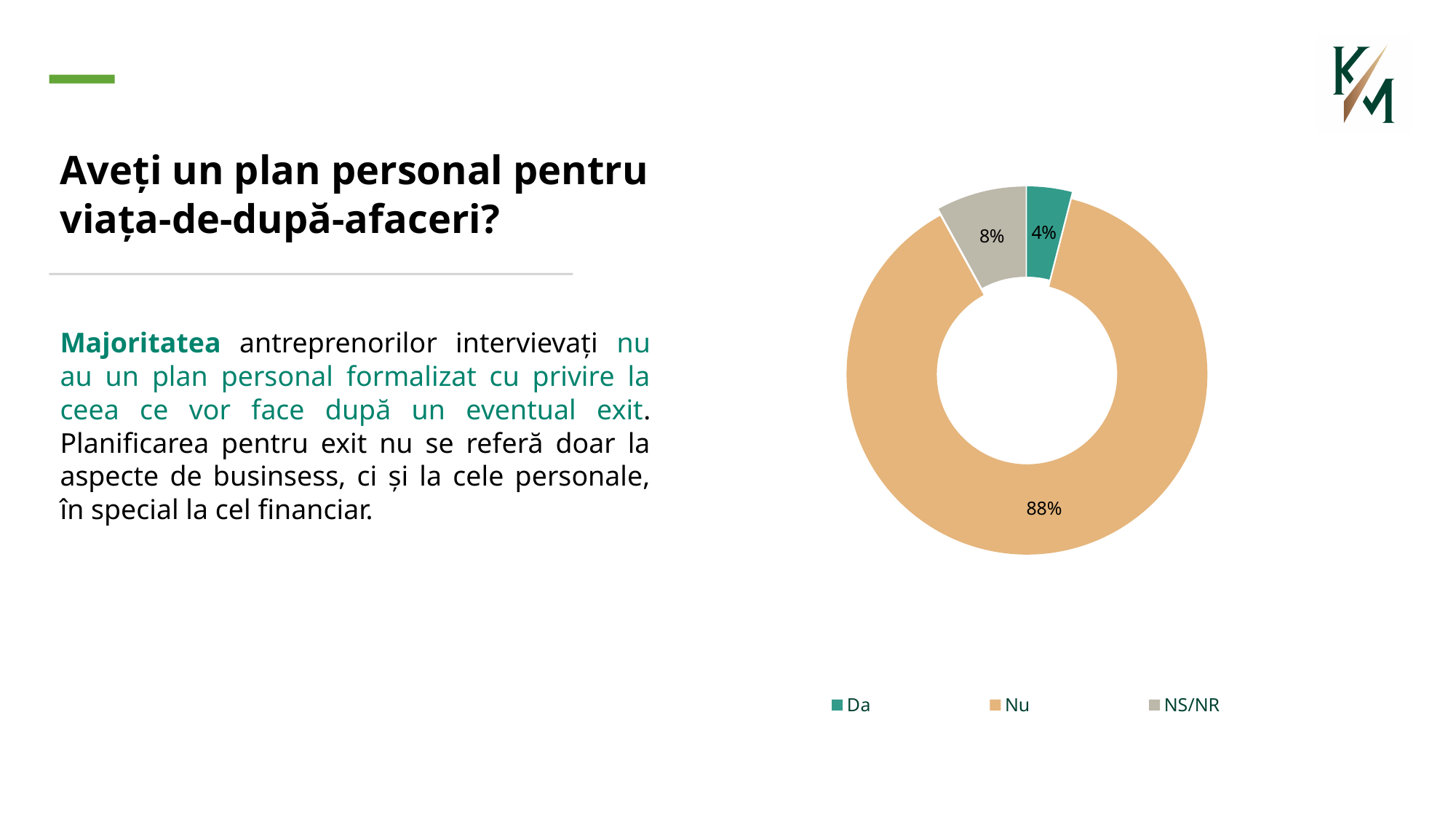
Which category has the largest share of the chart? Nu Which category has the smallest share of the chart? Da What kind of chart is shown on the slide? Doughnut (pie) chart How many entries does the legend list? 3 What is the difference in percentage points between "Nu" and "Da"? 84 What percentage of respondents answered "Da"? 4% What is the difference in percentage points between "NS/NR" and "Da"? 4 How many categories does the chart show? 3 What percentage of respondents answered "Nu"? 88% What percentage of respondents answered "NS/NR"? 8% Which colour represents the "Da" category in the chart? Green (teal) Which is larger, the share for "NS/NR" or the share for "Da"? NS/NR